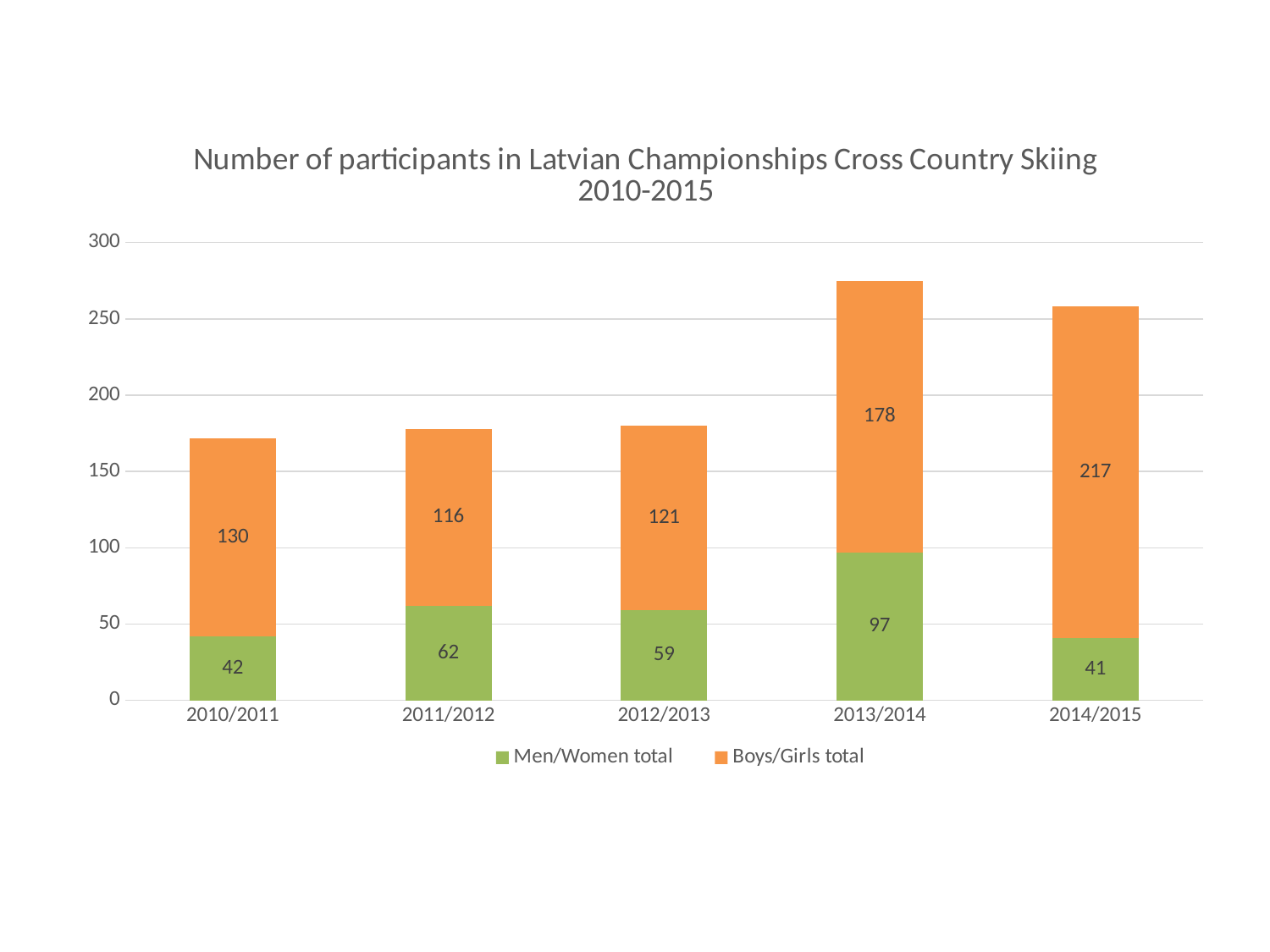
Is the total height of the 2013/2014 bar greater or less than 250? greater How many seasons are shown on the x axis? 5 Which season has the lowest Boys/Girls total? 2011/2012 What is the Men/Women total for 2010/2011? 42 Which season has the highest Men/Women total? 2013/2014 What is the total number of participants in 2013/2014 (both series combined)? 275 What is the difference between the Boys/Girls total in 2014/2015 and in 2013/2014? 39 What kind of chart is shown on the slide? Stacked bar chart What is the Boys/Girls total for 2014/2015? 217 How many series does the legend list? 2 What is the Boys/Girls total for 2012/2013? 121 Which is larger, the Men/Women total in 2011/2012 or in 2012/2013? 2011/2012